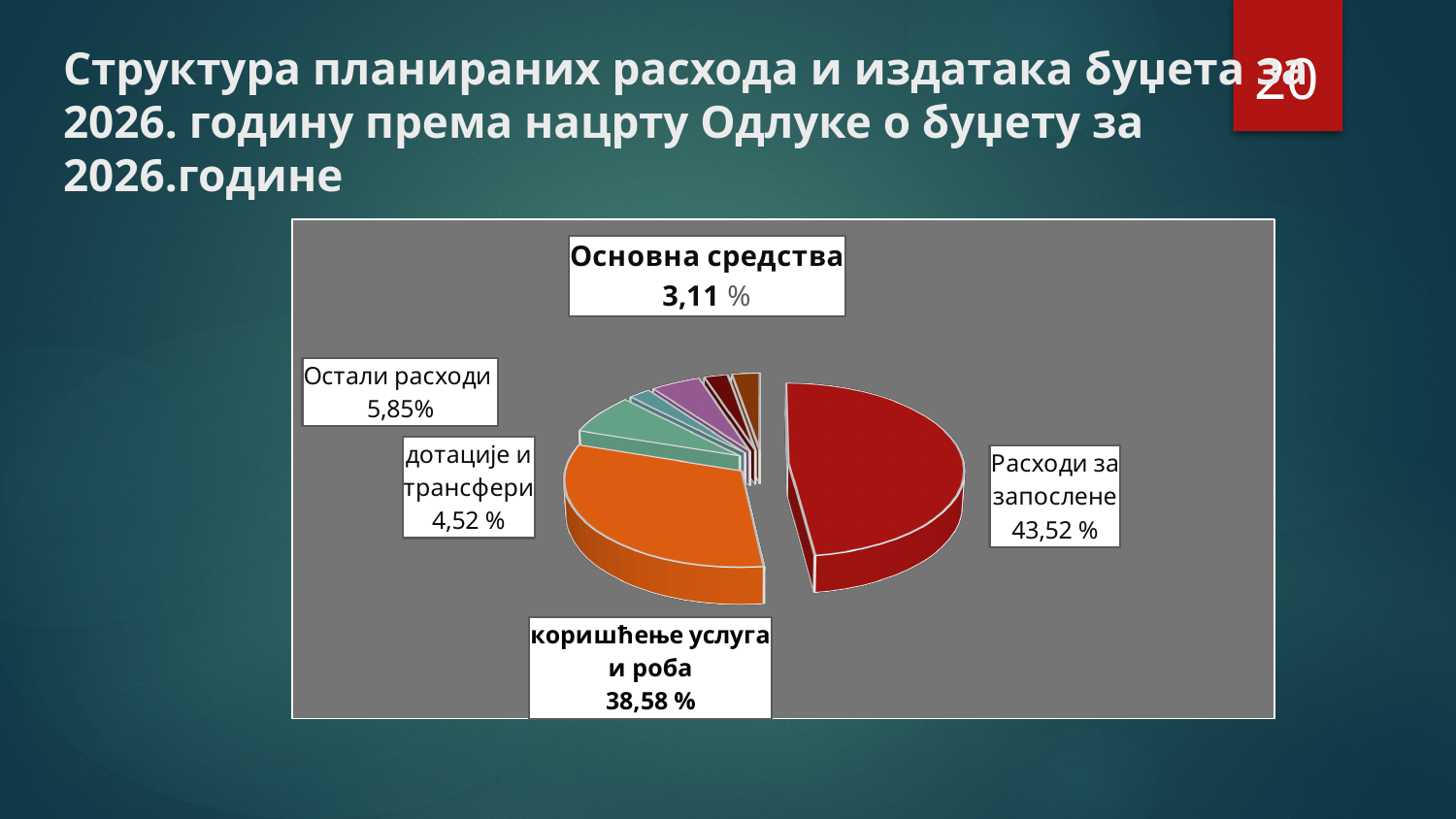
What value is printed for Остали расходи? 5,85% What share of the pie is labelled for Расходи за запослене? 43,52 % Which labelled category has the smallest share of the pie? Основна средства Which is larger: the share for дотације и трансфери or the share for Основна средства? дотације и трансфери What percentage is shown for коришћење услуга и роба? 38,58 % What percentage is shown for дотације и трансфери? 4,52 % Which is larger: the share for Остали расходи or the share for дотације и трансфери? Остали расходи By how many percentage points does Расходи за запослене exceed коришћење услуга и роба? 4,94 What type of chart is shown on the slide? Pie chart What colour is the slice for Расходи за запослене? Red Which labelled category has the largest share of the pie? Расходи за запослене What share is labelled for Основна средства? 3,11 %